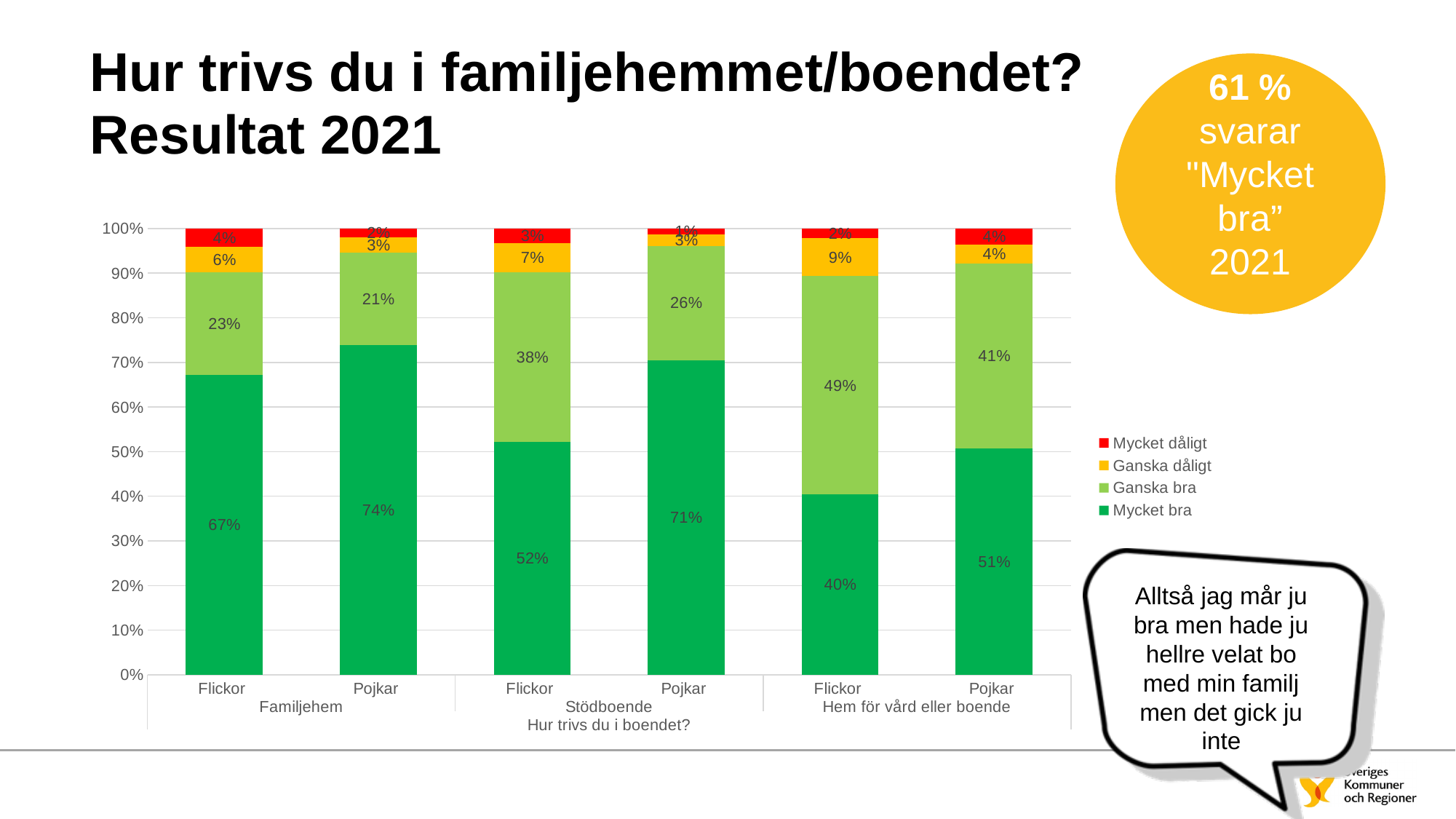
How many series does the legend list? 4 What type of chart is shown on the slide? Stacked bar chart What percentage of Pojkar in Stödboende answered "Ganska bra"? 26% How many bars are shown in the chart? 6 Which group has the highest share of "Mycket bra" answers? Pojkar, Familjehem Which colour represents "Mycket dåligt" in the chart? Red What is the difference in "Mycket bra" share between Pojkar and Flickor in Stödboende? 19 percentage points Which group has the lowest share of "Mycket bra" answers? Flickor, Hem för vård eller boende What percentage of Flickor in Hem för vård eller boende answered "Ganska dåligt"? 9% Which is larger: the "Ganska bra" share for Flickor in Hem för vård eller boende or for Flickor in Stödboende? Flickor in Hem för vård eller boende What percentage of Pojkar in Hem för vård eller boende answered "Mycket bra"? 51% What percentage of Flickor in Familjehem answered "Mycket bra"? 67%